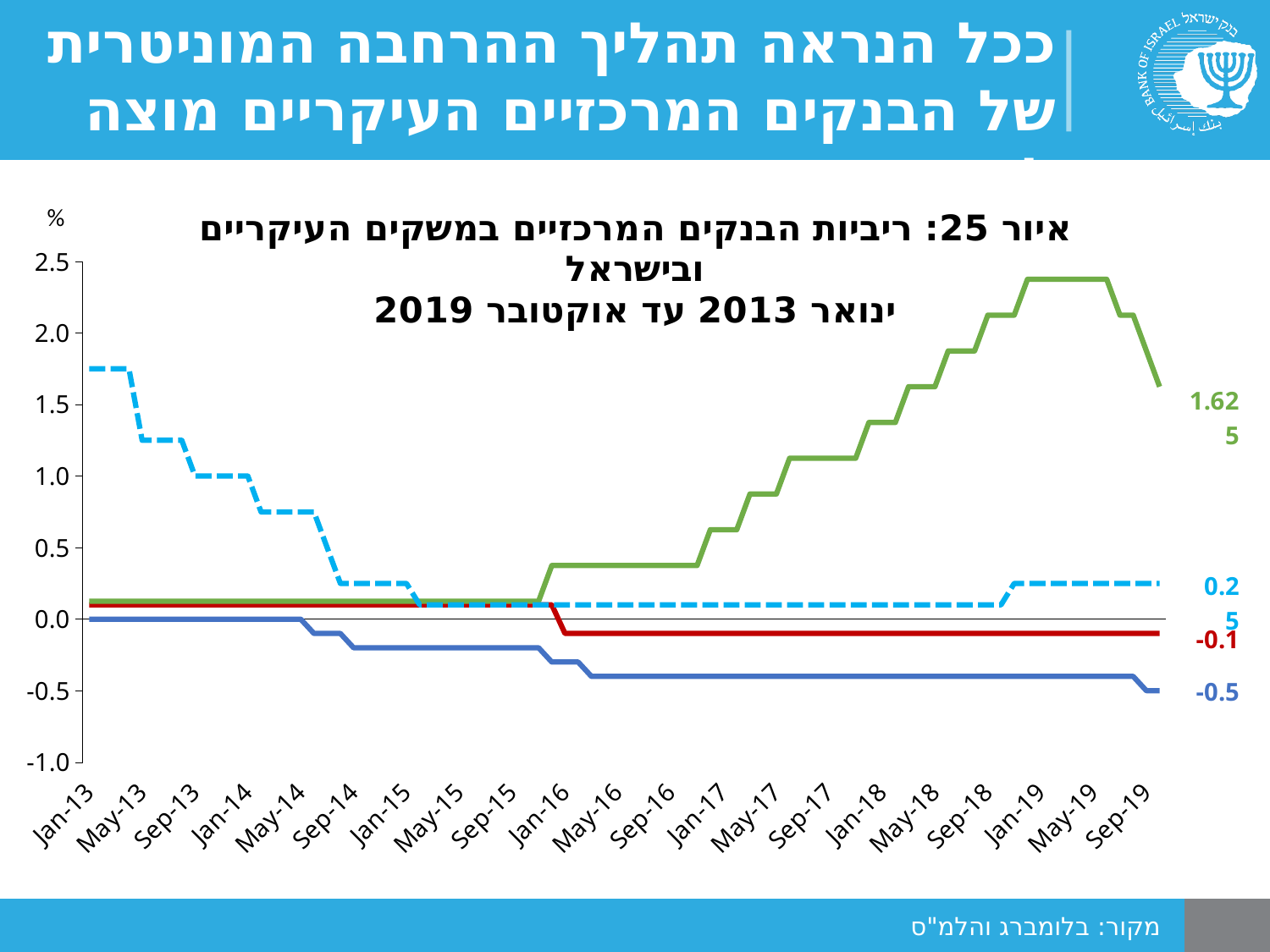
What unit is shown on the vertical axis of the chart? % Which line has the highest labelled end value? the green line Which line has the lowest labelled end value? the dark blue line Is the value of the green line at Jan-19 greater or less than 2.0? greater What is the final value labelled at the end of the dark blue line? -0.5 What is the final value labelled at the end of the green line? 1.625 What type of chart is shown on the slide? line chart What is the final value labelled at the end of the light blue dashed line? 0.25 What is the final value labelled at the end of the red line? -0.1 How many lines are plotted on the chart? 4 What is the difference between the labelled end values of the green line and the dark blue line? 2.125 Does the light blue dashed line rise or fall between Jan-13 and Jan-15? fall